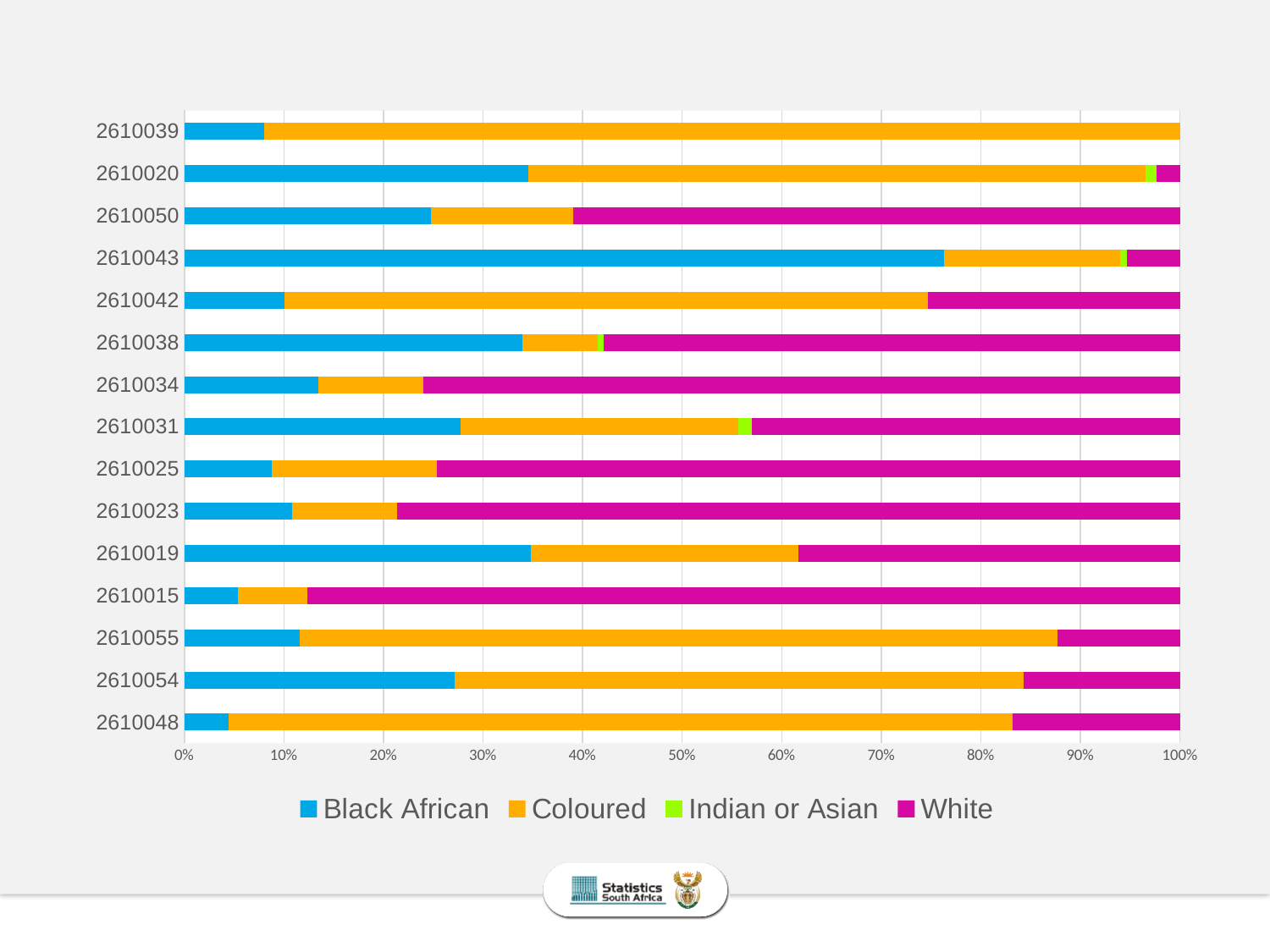
Is the Black African share for 2610020 greater or less than 30%? greater Is the Black African share for 2610039 greater or less than 10%? less What colour represents the Coloured series? orange Is the Black African share for 2610042 greater or less than 20%? less Which category has the largest Black African share? 2610043 How many series does the legend list? 4 Which has the larger Black African share, 2610054 or 2610055? 2610054 Which has the larger Black African share, 2610019 or 2610015? 2610019 What kind of chart is shown on the slide? bar chart What are the series names listed in the legend? Black African, Coloured, Indian or Asian, White How many categories (area codes) are plotted on the chart? 15